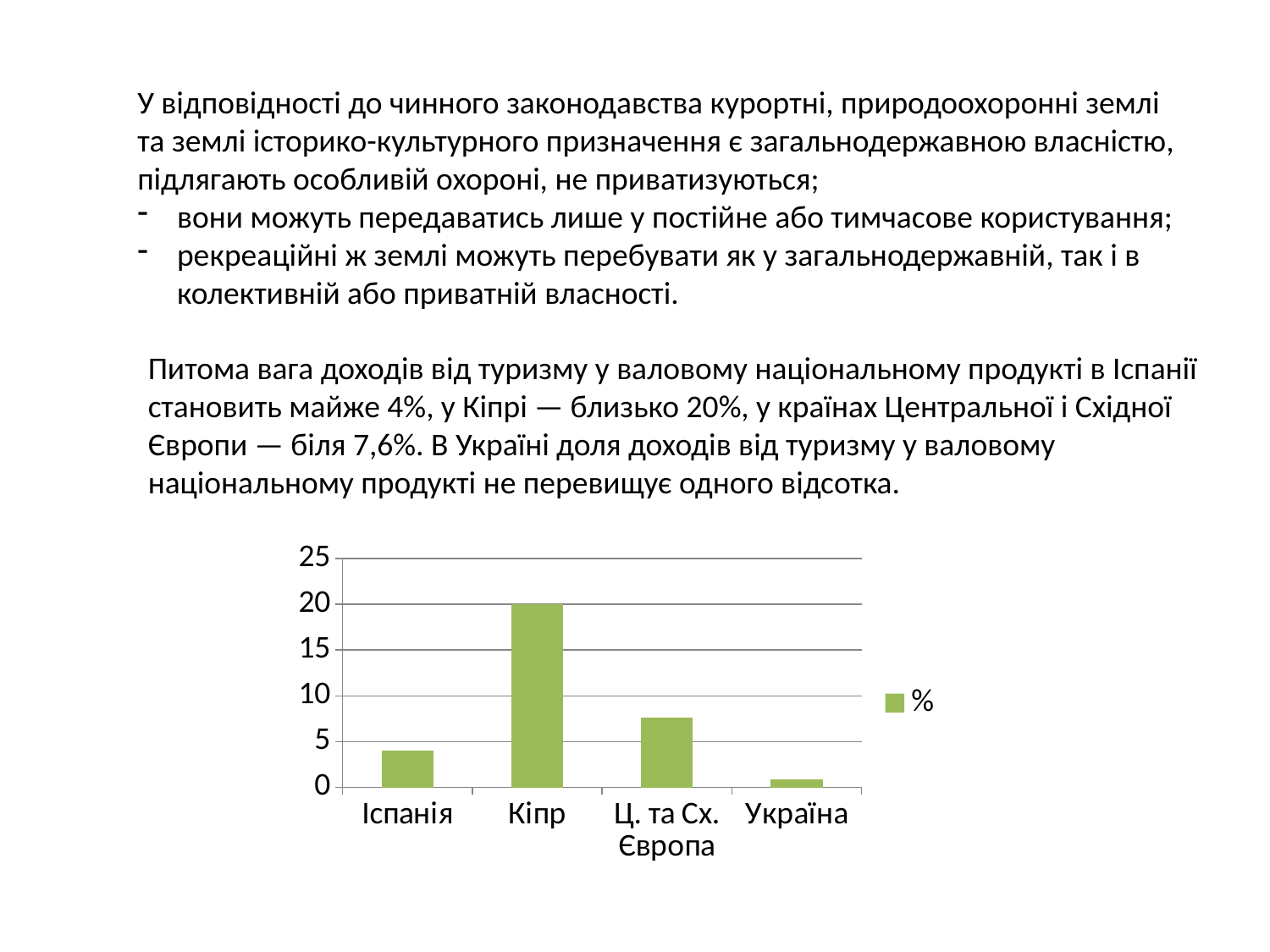
Is the value for Ц. та Сх. Європа greater or less than 5? greater Which category has the highest bar in the chart? Кіпр Is the value for Іспанія greater or less than 5? less What is the value for Кіпр in the chart? 20 Is the value for Ц. та Сх. Європа greater or less than 10? less Which is larger in the chart, the value for Іспанія or the value for Ц. та Сх. Європа? Ц. та Сх. Європа How many categories are shown on the x axis of the chart? 4 How many series does the chart legend list? 1 What kind of chart is shown on the slide? bar chart Which category has the lowest bar in the chart? Україна What is the name of the series shown in the chart legend? %